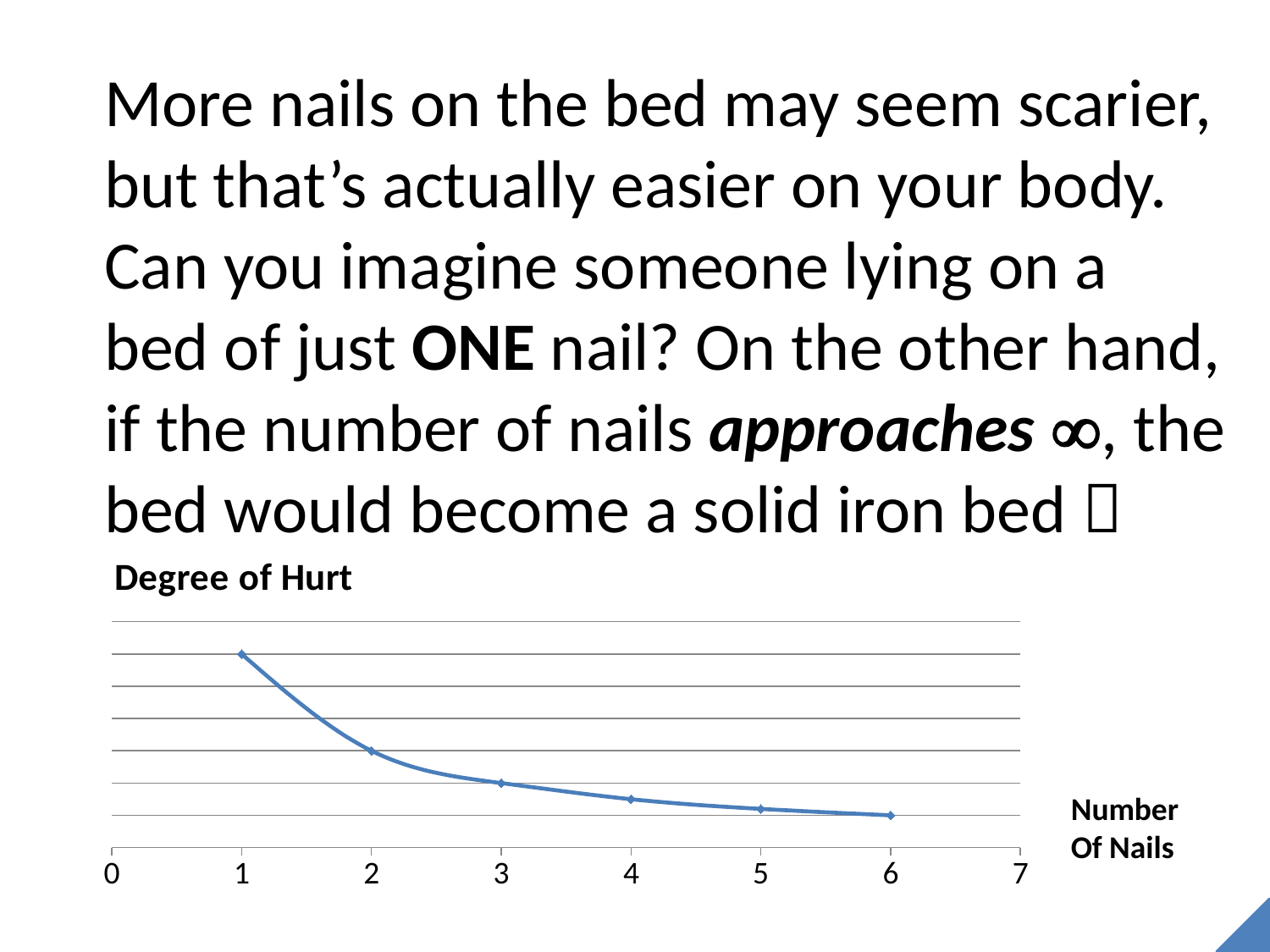
Do the values rise or fall as the number of nails increases along the x axis? fall What is the label shown above the chart for the vertical quantity? Degree of Hurt Which has a higher degree of hurt, 2 nails or 5 nails? 2 nails What is the label of the x axis? Number Of Nails What kind of chart is shown on the slide? line chart At which number of nails is the degree of hurt lowest? 6 How many data points are plotted on the line? 6 At which number of nails is the degree of hurt highest? 1 Which has a higher degree of hurt, 1 nail or 2 nails? 1 nail What is the highest value shown on the x axis? 7